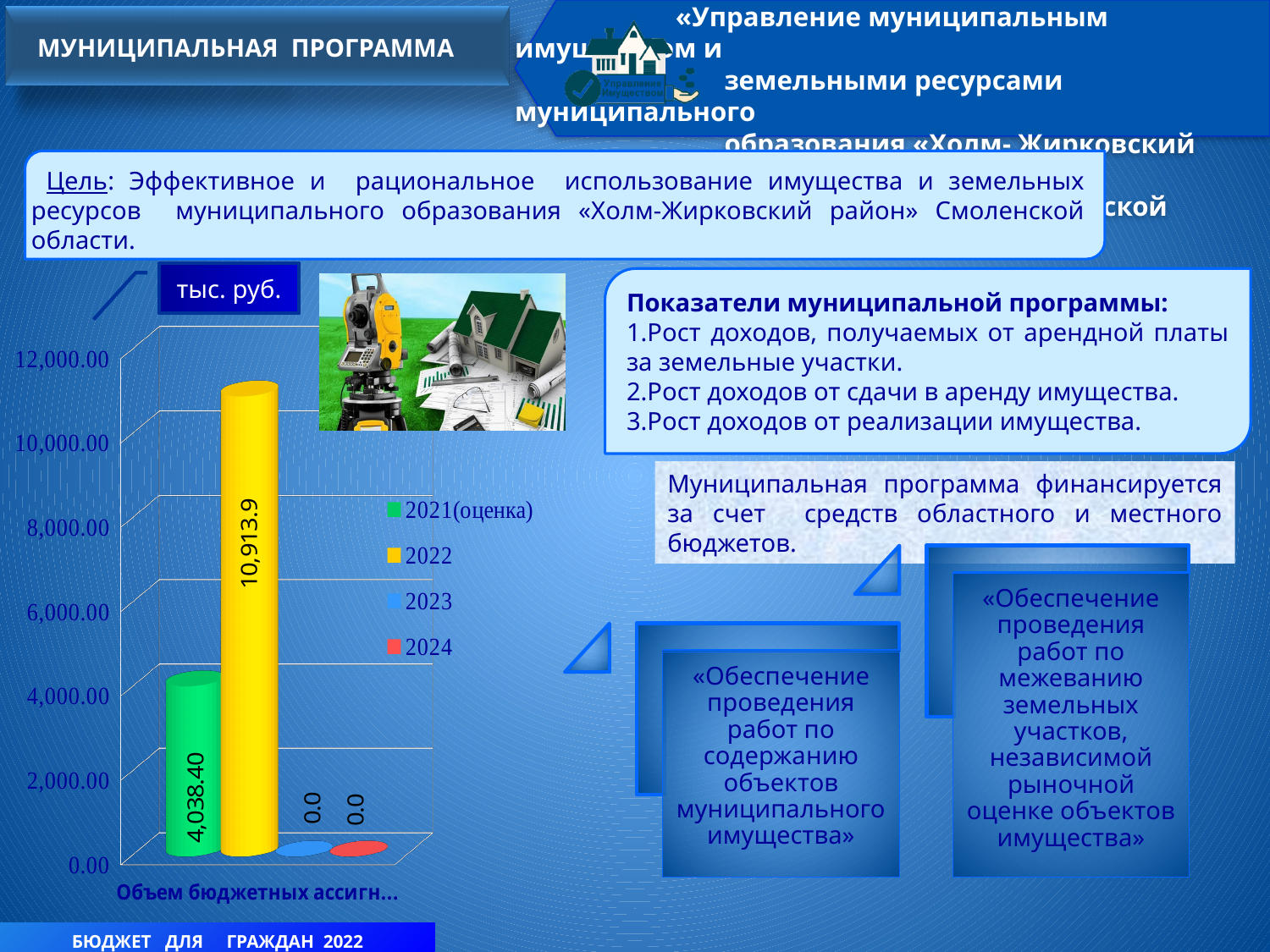
Which series has the highest value on the chart? 2022 Is the value for 2021(оценка) greater or less than 6,000.00? less What is the value for the 2021(оценка) series on the chart? 4,038.40 Is the value for 2022 greater or less than 10,000.00? greater What unit is shown in the label above the chart? тыс. руб. What is the value for the 2022 series on the chart? 10,913.9 What is the value for the 2024 series on the chart? 0.0 What is the difference between the 2022 value and the 2021(оценка) value? 6,875.5 What is the value for the 2023 series on the chart? 0.0 How many series does the chart legend list? 4 Which is larger, the value for 2021(оценка) or the value for 2022? 2022 What kind of chart is shown on the slide? bar chart